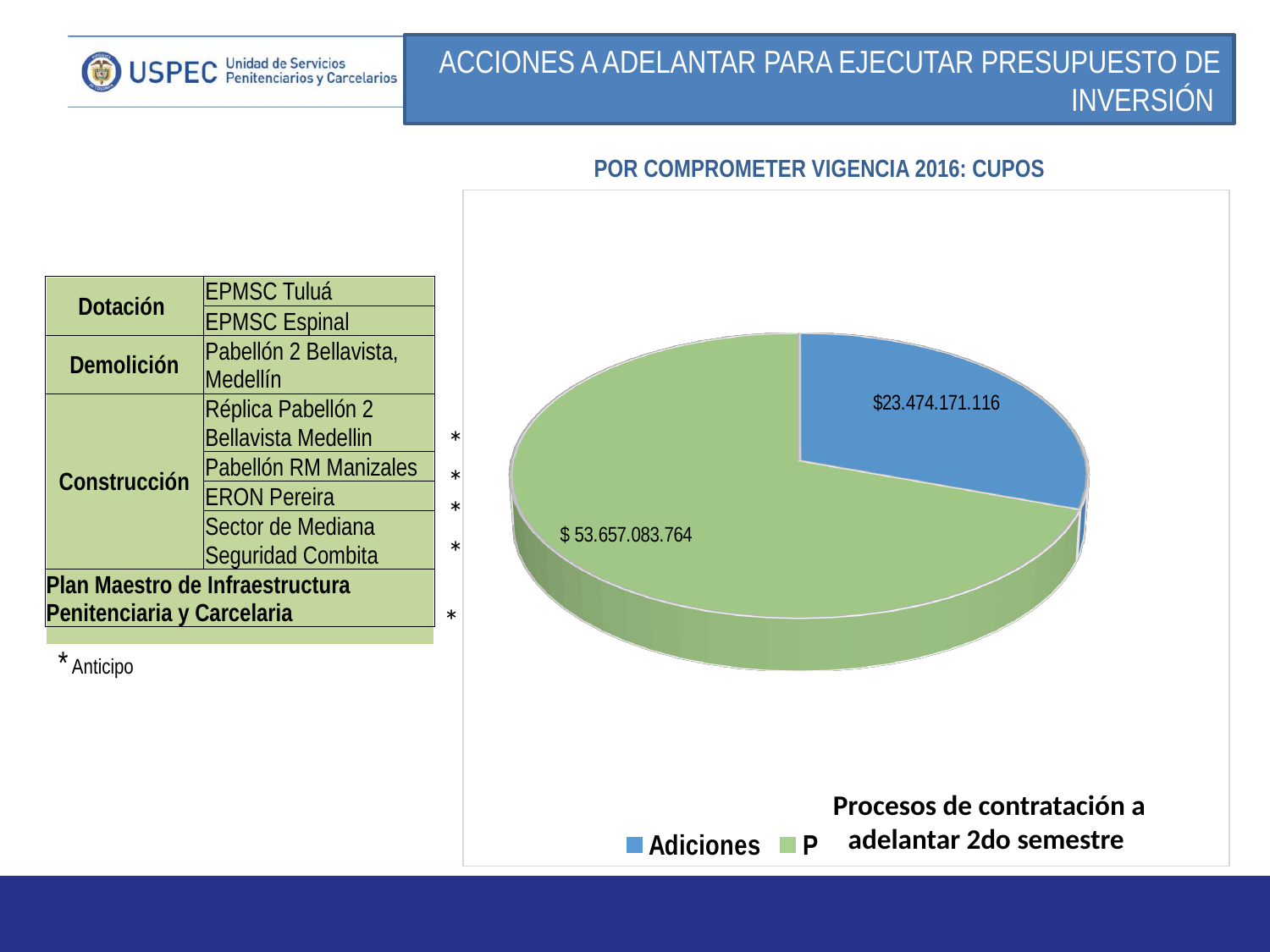
Which slice of the pie chart is the smallest? Adiciones What type of chart is shown on the slide? Pie chart Which is larger in the pie chart: Adiciones or Procesos de contratación a adelantar 2do semestre? Procesos de contratación a adelantar 2do semestre What colour is the Adiciones slice in the pie chart? Blue What is the difference between the Procesos de contratación a adelantar 2do semestre value and the Adiciones value in the pie chart? $30.182.912.648 What is the total of the two values shown in the pie chart? $77.131.254.880 How many slices does the pie chart have? 2 What is the value shown for the Procesos de contratación a adelantar 2do semestre slice of the pie chart? $ 53.657.083.764 What is the title of the chart on the slide? POR COMPROMETER VIGENCIA 2016: CUPOS Which slice of the pie chart is the largest? Procesos de contratación a adelantar 2do semestre What is the value shown for the Adiciones slice of the pie chart? $23.474.171.116